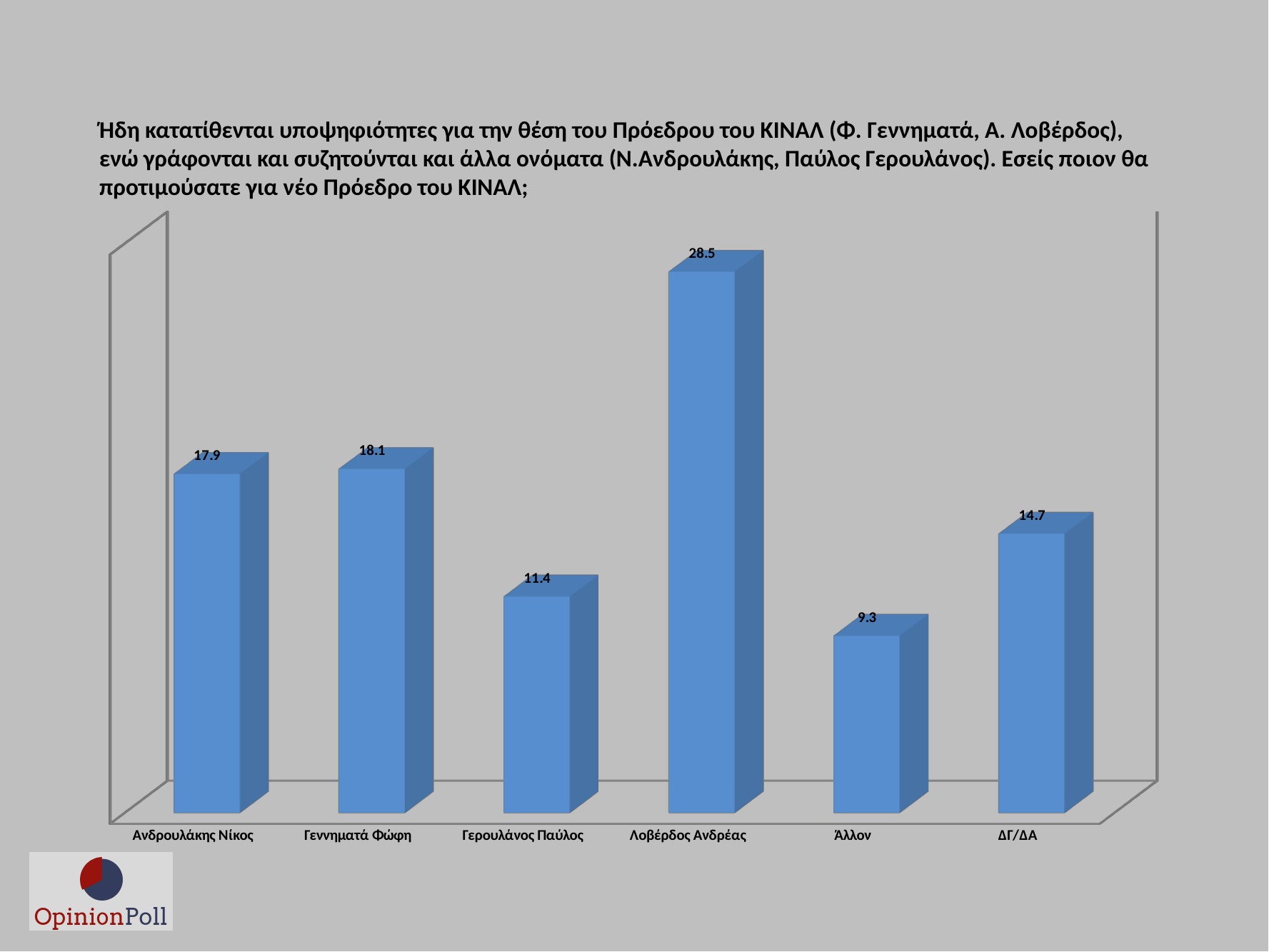
What value is shown for Γεννηματά Φώφη? 18.1 Which is larger, the value for Γερουλάνος Παύλος or the value for ΔΓ/ΔΑ? ΔΓ/ΔΑ What is the difference between the values for Γερουλάνος Παύλος and Άλλον? 2.1 What value is shown for ΔΓ/ΔΑ? 14.7 What is the difference between the values for Λοβέρδος Ανδρέας and Γεννηματά Φώφη? 10.4 Which category has the highest value? Λοβέρδος Ανδρέας Which category has the lowest value? Άλλον How many categories are shown on the chart? 6 What value is shown for Άλλον? 9.3 What kind of chart is shown on the slide? Bar chart What value is shown for Ανδρουλάκης Νίκος? 17.9 What value is shown for Λοβέρδος Ανδρέας? 28.5